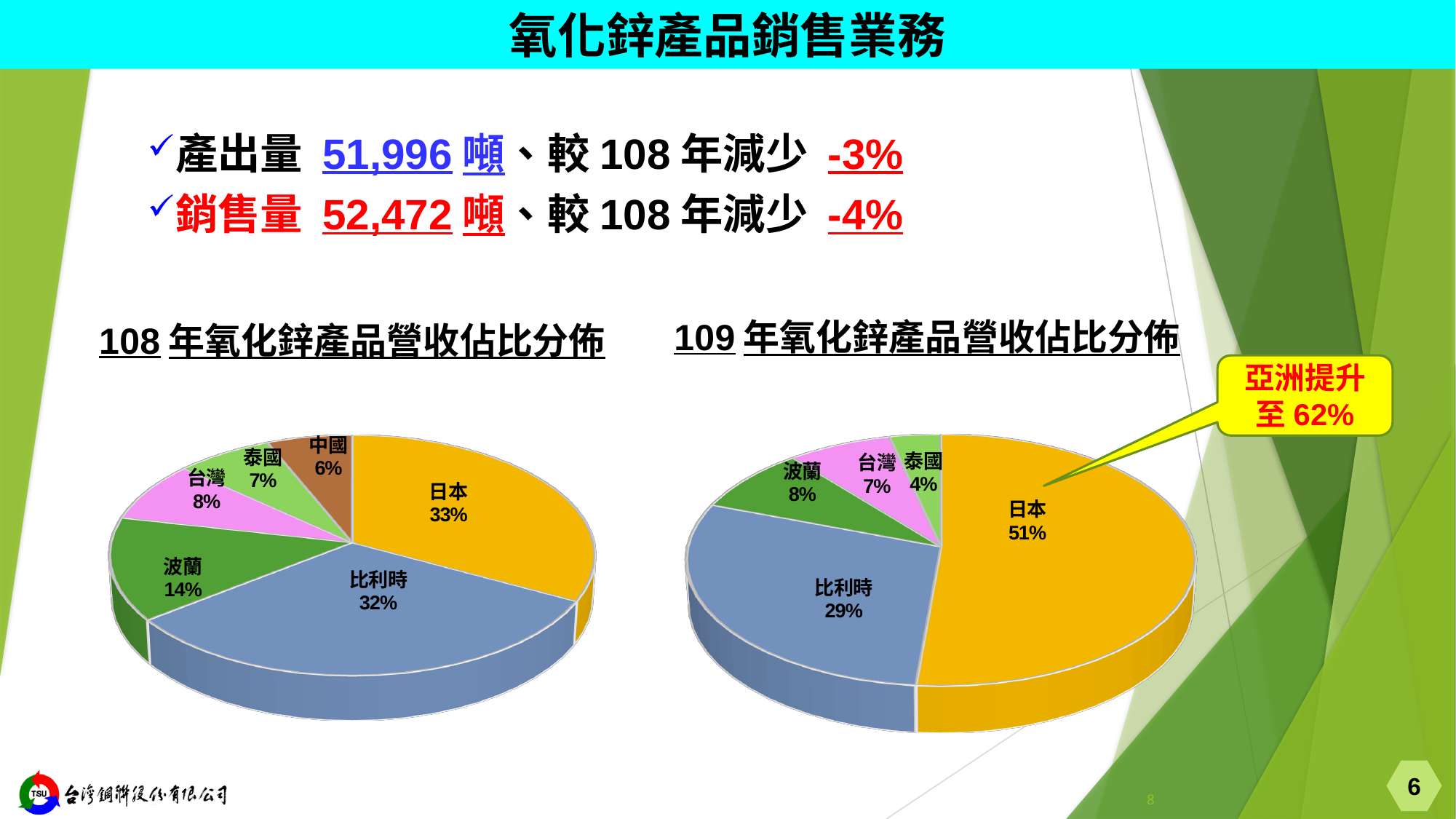
In the 109 年氧化鋅產品營收佔比分佈 pie chart, which category has the smallest share? 泰國 How many categories are shown in the 109 年氧化鋅產品營收佔比分佈 pie chart? 5 What type of chart is used for the 109 年氧化鋅產品營收佔比分佈? Pie chart In the 108 年氧化鋅產品營收佔比分佈 pie chart, which is larger, the share of 波蘭 or the share of 台灣? 波蘭 In the 109 年氧化鋅產品營收佔比分佈 pie chart, what share does 泰國 have? 4% How many categories are shown in the 108 年氧化鋅產品營收佔比分佈 pie chart? 6 In the 108 年氧化鋅產品營收佔比分佈 pie chart, what share does 日本 have? 33% In the 109 年氧化鋅產品營收佔比分佈 pie chart, what share does 比利時 have? 29% What is the difference between 日本's share in the 109 年 pie chart and its share in the 108 年 pie chart? 18% In the 108 年氧化鋅產品營收佔比分佈 pie chart, what share does 波蘭 have? 14% In the 109 年氧化鋅產品營收佔比分佈 pie chart, which category has the largest share? 日本 In the 108 年氧化鋅產品營收佔比分佈 pie chart, which category has the smallest share? 中國